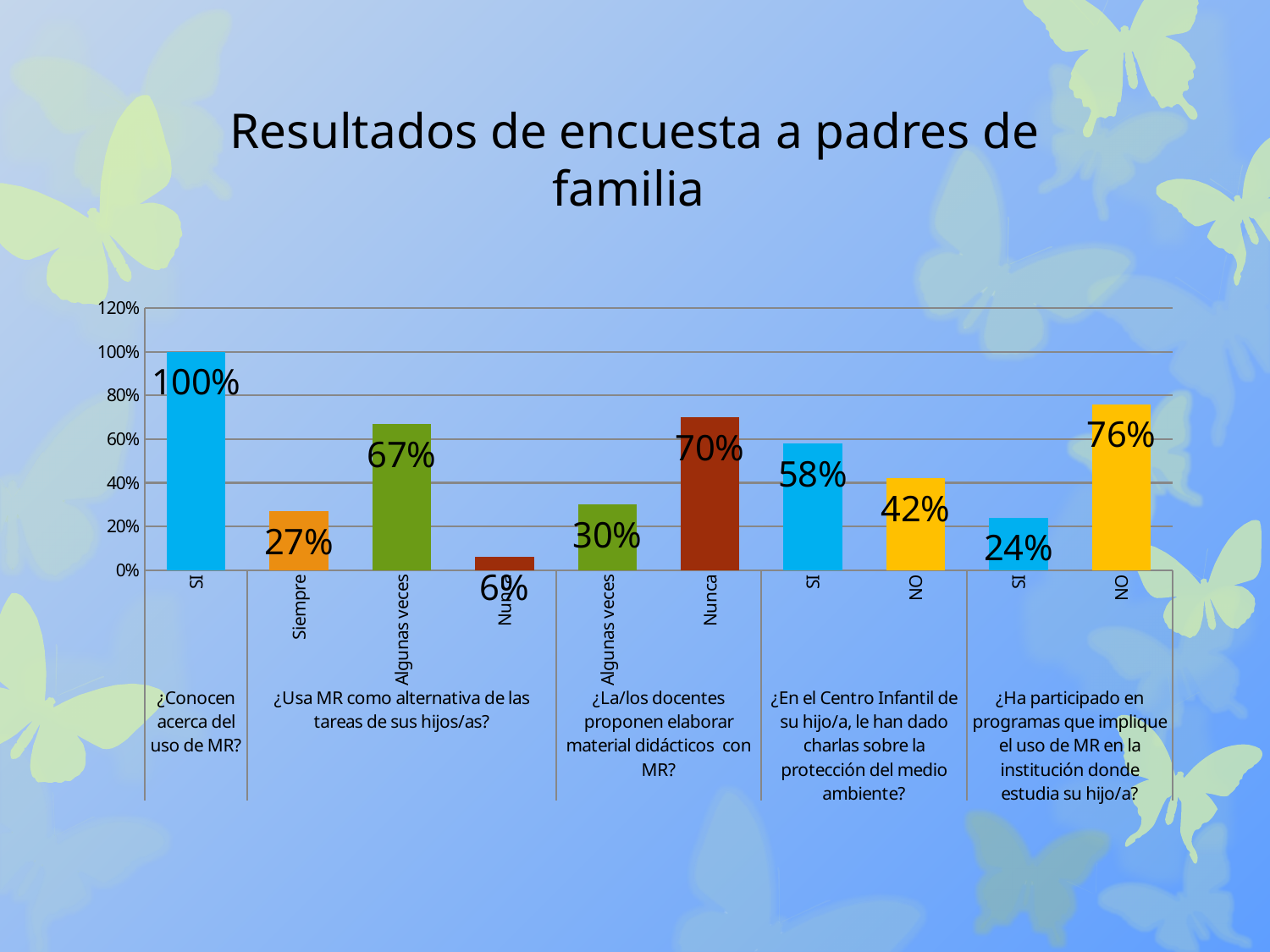
In the group "¿La/los docentes proponen elaborar material didácticos con MR?", what is the value for Nunca? 70% In the group "¿Usa MR como alternativa de las tareas de sus hijos/as?", what is the value for Algunas veces? 67% How many bars are plotted in the chart? 10 Is the value for Algunas veces in the group "¿La/los docentes proponen elaborar material didácticos con MR?" greater or less than 40%? less Which bar has the lowest value in the chart? Nunca (¿Usa MR como alternativa de las tareas de sus hijos/as?), 6% What is the value for NO in the group "¿Ha participado en programas que implique el uso de MR en la institución donde estudia su hijo/a?"? 76% In the group "¿Usa MR como alternativa de las tareas de sus hijos/as?", which is larger: Siempre or Algunas veces? Algunas veces What is the title of the slide containing the chart? Resultados de encuesta a padres de familia What type of chart is shown on the slide? bar chart What is the difference between SI and NO in the group "¿En el Centro Infantil de su hijo/a, le han dado charlas sobre la protección del medio ambiente?"? 16% Which bar has the highest value in the chart? SI (¿Conocen acerca del uso de MR?), 100% What percentage of parents answered SI to "¿Conocen acerca del uso de MR?"? 100%